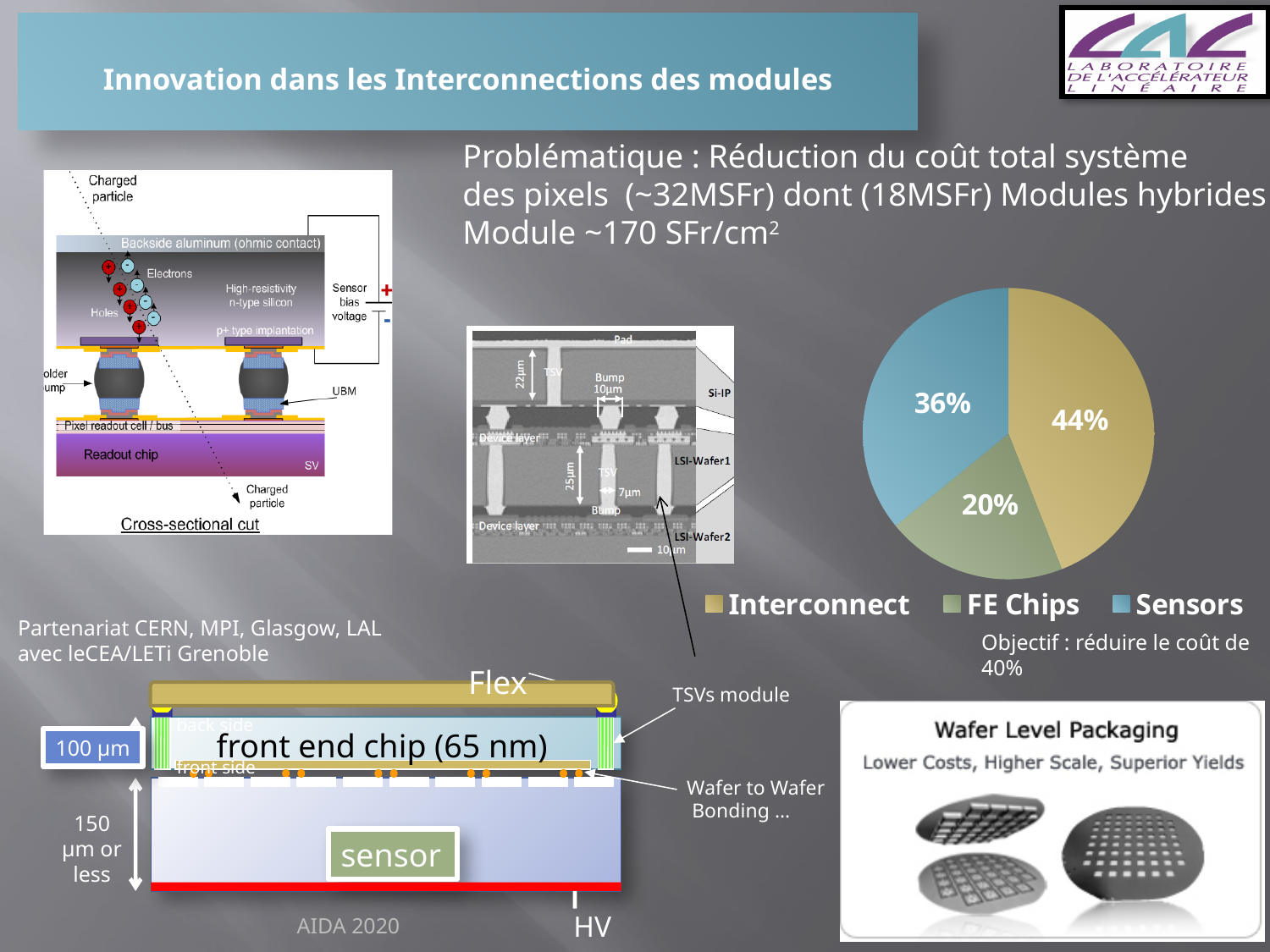
What kind of chart is shown on the slide? pie chart What colour is the Sensors slice in the pie chart? blue What share of the pie chart does FE Chips represent? 20% What is the difference in percentage points between the Sensors slice and the FE Chips slice? 16 Which category has the largest slice in the pie chart? Interconnect Which category has the smallest slice in the pie chart? FE Chips How many slices does the pie chart have? 3 What is the difference in percentage points between the Interconnect slice and the Sensors slice? 8 How many entries does the pie chart legend list? 3 What share of the pie chart does Interconnect represent? 44% What share of the pie chart does Sensors represent? 36% Which slice is larger in the pie chart, Sensors or FE Chips? Sensors